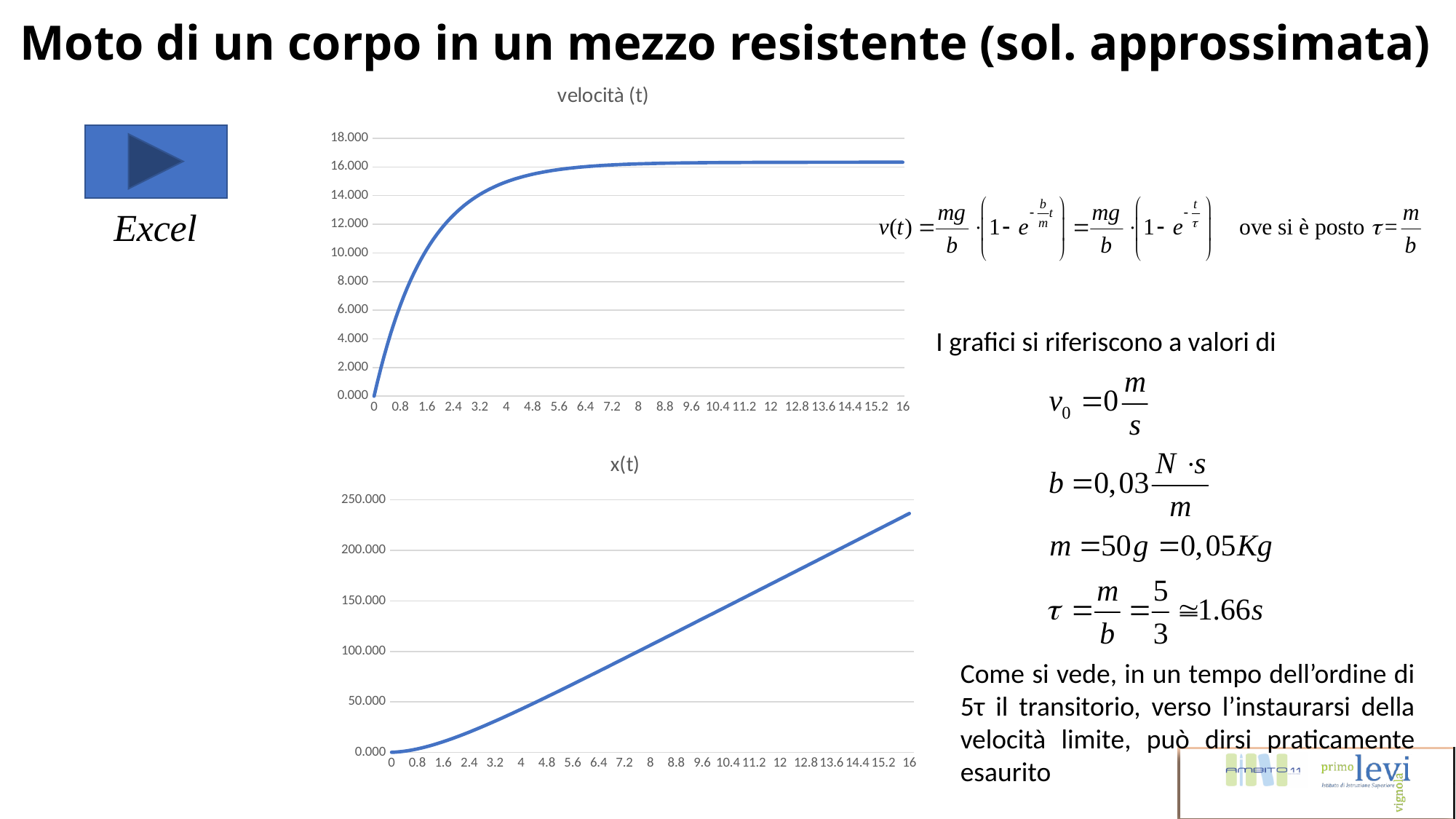
In the 'velocità (t)' chart, what is the value at t = 0? 0.000 What is the title of the lower chart on the slide? x(t) What kind of chart is the 'x(t)' chart? line chart What is the title of the upper chart on the slide? velocità (t) In the 'x(t)' chart, do the values rise or fall as t increases? rise In the 'x(t)' chart, is the value at t = 16 greater or less than 250.000? less In the 'velocità (t)' chart, do the values rise or fall as t increases? rise In the 'velocità (t)' chart, is the value at t = 8 greater or less than 14.000? greater In the 'x(t)' chart, is the value at t = 4 greater or less than 50.000? less What kind of chart is the 'velocità (t)' chart? line chart